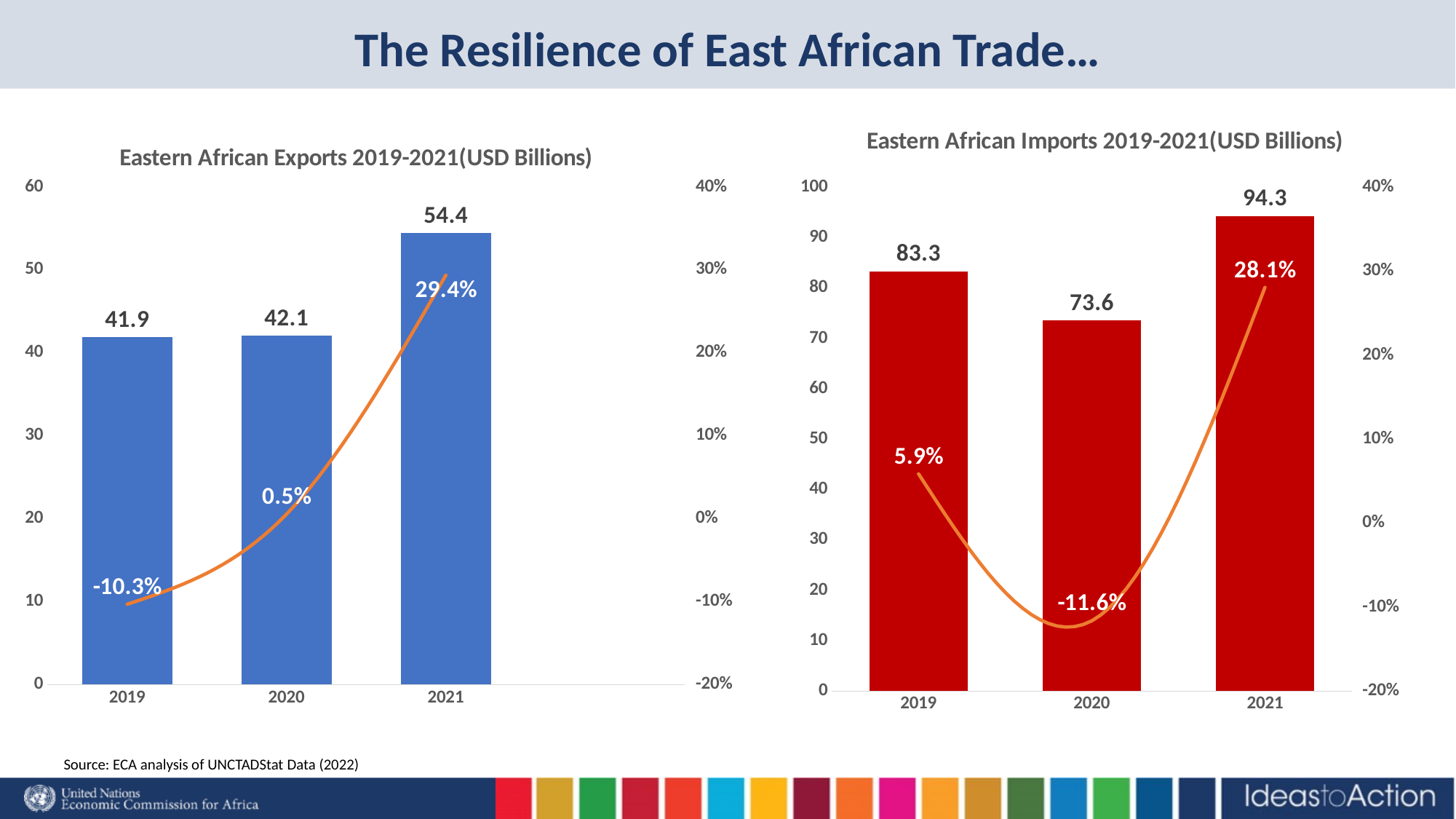
In the Eastern African Imports 2019-2021 chart, which is larger, the import value for 2019 or for 2020? 2019 In the Eastern African Exports 2019-2021 chart, which year has the highest export value? 2021 In the Eastern African Exports 2019-2021 chart, what is the difference between the export values for 2021 and 2020? 12.3 How many years are shown on the x axis of the Eastern African Exports 2019-2021 chart? 3 In the Eastern African Imports 2019-2021 chart, what is the import value for 2020? 73.6 In the Eastern African Imports 2019-2021 chart, what is the difference between the import values for 2021 and 2019? 11 In the Eastern African Exports 2019-2021 chart, what is the export value for 2021? 54.4 In the Eastern African Imports 2019-2021 chart, what is the growth rate shown for 2021? 28.1% In the Eastern African Exports 2019-2021 chart, what is the growth rate shown for 2020? 0.5% In the Eastern African Imports 2019-2021 chart, which year has the lowest import value? 2020 What kind of chart is the Eastern African Imports 2019-2021 chart? Bar chart with a line In the Eastern African Imports 2019-2021 chart, what colour are the bars? Red